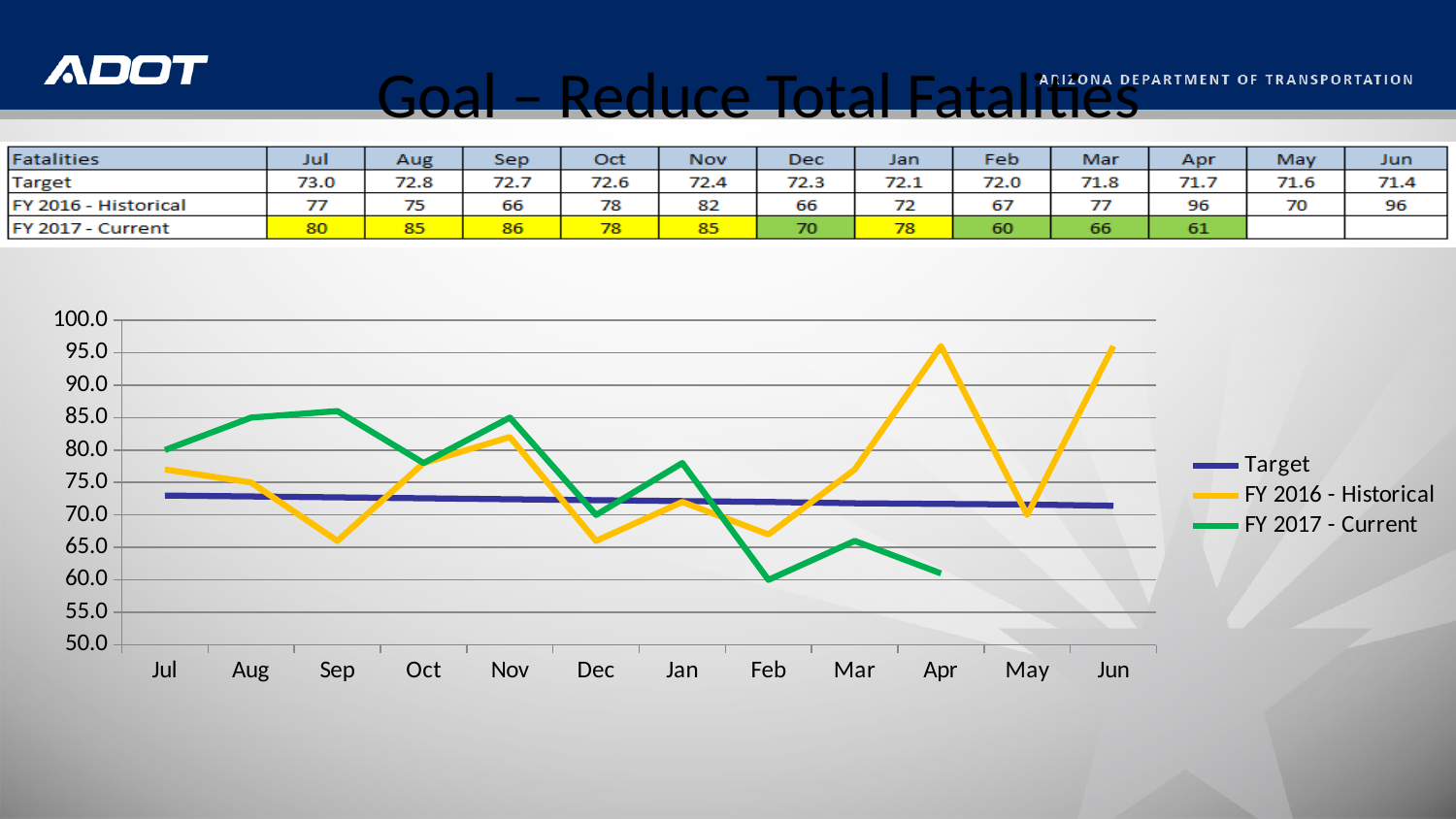
In which month is the FY 2017 - Current series highest? Sep Does the Target line rise or fall from Jul to Jun? falls What kind of chart is shown on the slide? line chart In which month is the FY 2017 - Current series lowest? Feb Is the FY 2016 - Historical value for Apr greater or less than 90? greater How many series does the chart legend list? 3 In Apr, which series has the larger value, FY 2016 - Historical or FY 2017 - Current? FY 2016 - Historical What is the difference between the FY 2017 - Current and FY 2016 - Historical values in Sep? 20 How many months are shown along the x axis of the chart? 12 What is the Target value for Jul? 73.0 What is the FY 2016 - Historical value for Nov? 82 What is the FY 2017 - Current value for Sep? 86